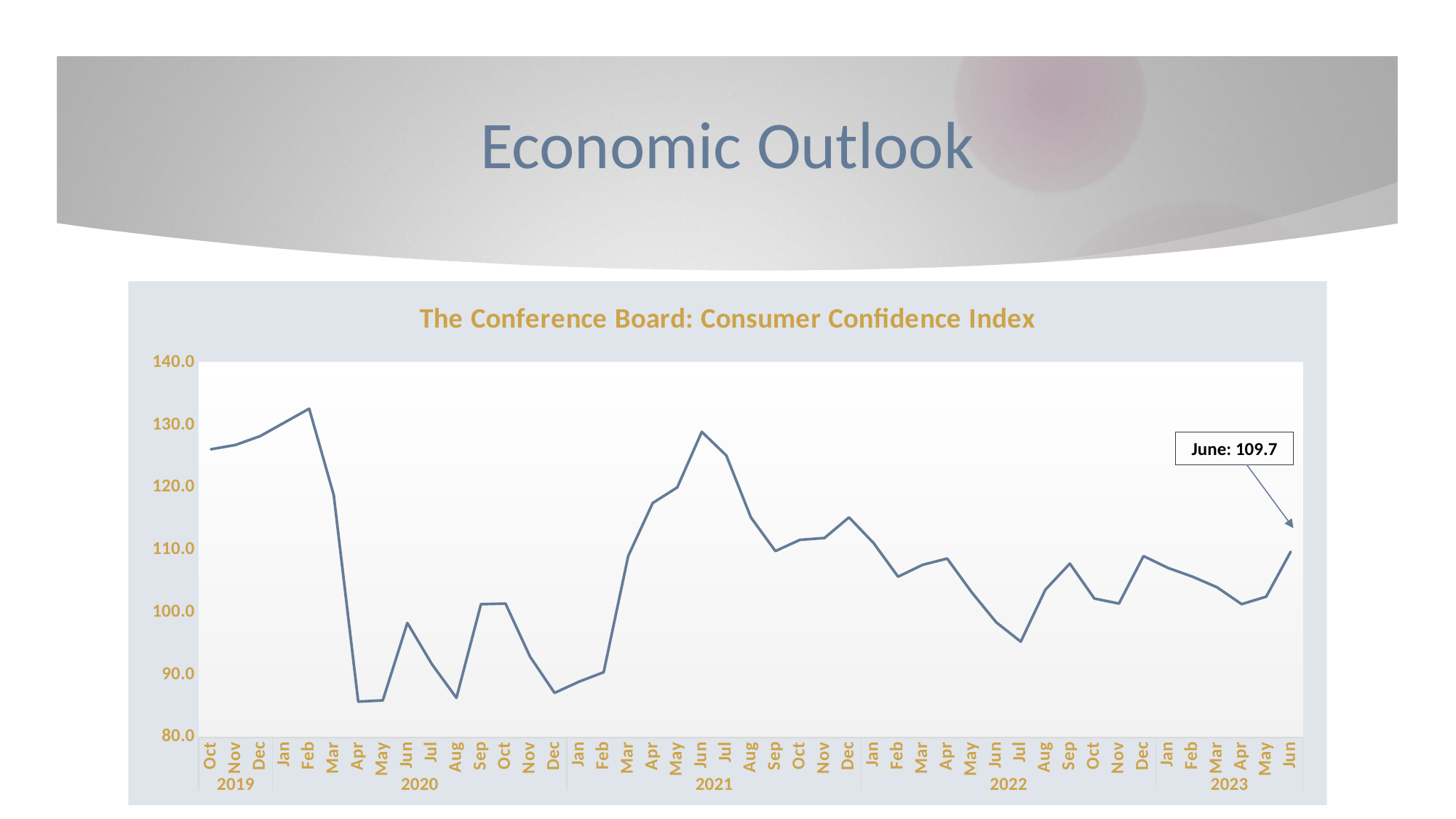
Is the value for Feb 2020 greater or less than 130? greater What kind of chart is shown on the slide? line chart What is the Consumer Confidence Index value labelled for June 2023? 109.7 Is the value for Apr 2020 greater or less than 90? less Which is higher, the value for Dec 2020 or the value for Jul 2022? Jul 2022 In which month does the Consumer Confidence Index reach its highest point on the chart? Feb 2020 How many years are labelled along the x axis of the chart? 5 Is the value for Jun 2021 greater or less than 120? greater Which is higher, the value for Feb 2020 or the value for Jun 2021? Feb 2020 What is the title of the chart? The Conference Board: Consumer Confidence Index Does the Consumer Confidence Index rise or fall between Feb 2020 and Apr 2020? fall